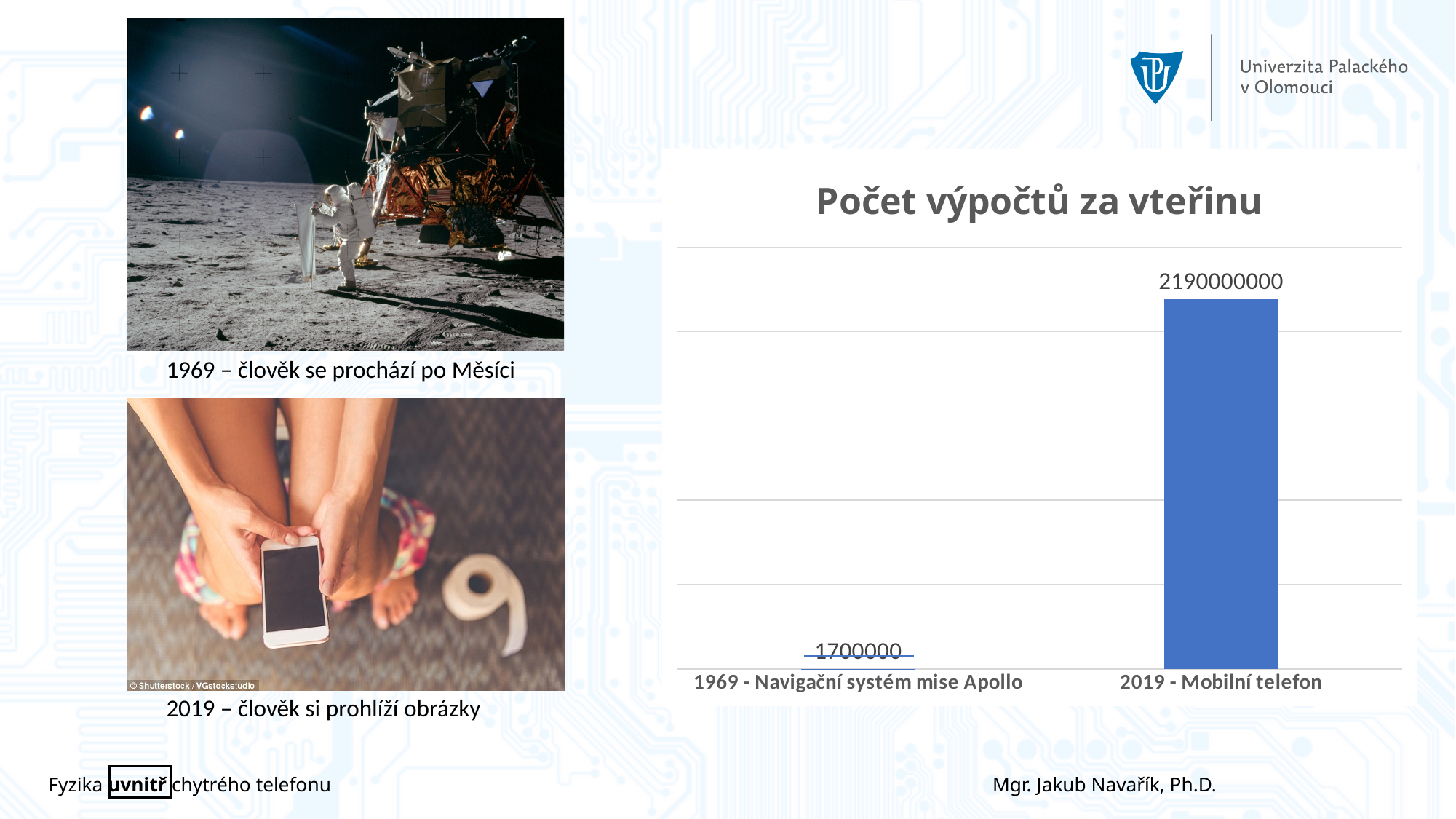
What is the difference between the value for "2019 - Mobilní telefon" and the value for "1969 - Navigační systém mise Apollo"? 2188300000 Do the values rise or fall from left to right along the x axis? rise What colour are the bars in the chart? blue Which category has the highest value? 2019 - Mobilní telefon Which is larger, the value for "1969 - Navigační systém mise Apollo" or the value for "2019 - Mobilní telefon"? 2019 - Mobilní telefon What type of chart is shown on the slide? bar chart What is the title of the chart? Počet výpočtů za vteřinu Which category has the lowest value? 1969 - Navigační systém mise Apollo What is the value for "2019 - Mobilní telefon"? 2190000000 What is the value for "1969 - Navigační systém mise Apollo"? 1700000 How many categories are shown in the chart? 2